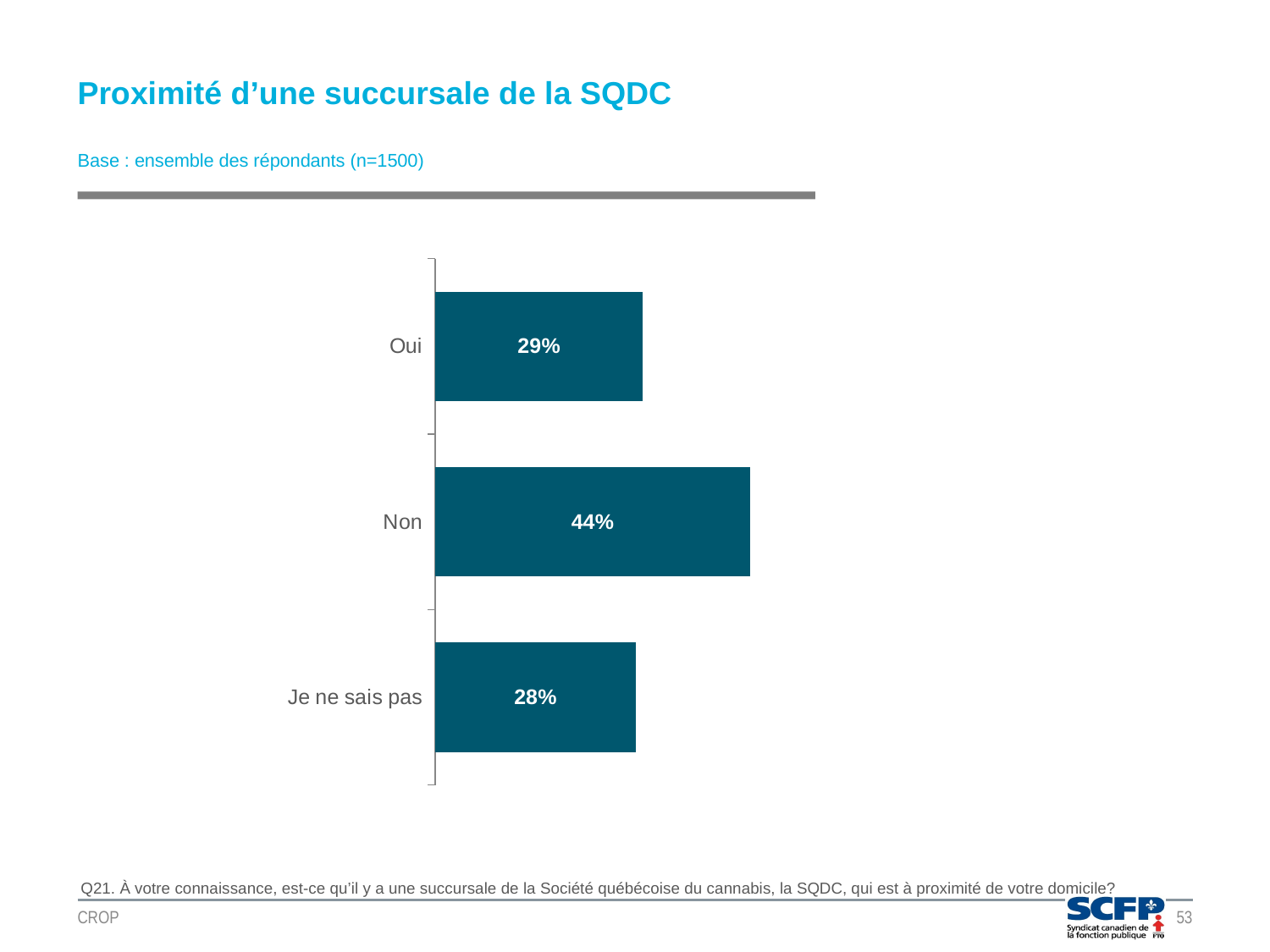
What is the difference in percentage points between "Non" and "Oui"? 15 How many response categories are shown in the chart? 3 What is the base (number of respondents) stated on the slide? n=1500 Which is larger, the value for "Non" or the value for "Je ne sais pas"? Non What percentage of respondents answered "Oui"? 29% What is the title of the slide? Proximité d’une succursale de la SQDC What is the difference in percentage points between "Oui" and "Je ne sais pas"? 1 What percentage of respondents answered "Je ne sais pas"? 28% Which response category has the lowest percentage? Je ne sais pas What type of chart is shown on the slide? Bar chart What percentage of respondents answered "Non"? 44% Which response category has the highest percentage? Non